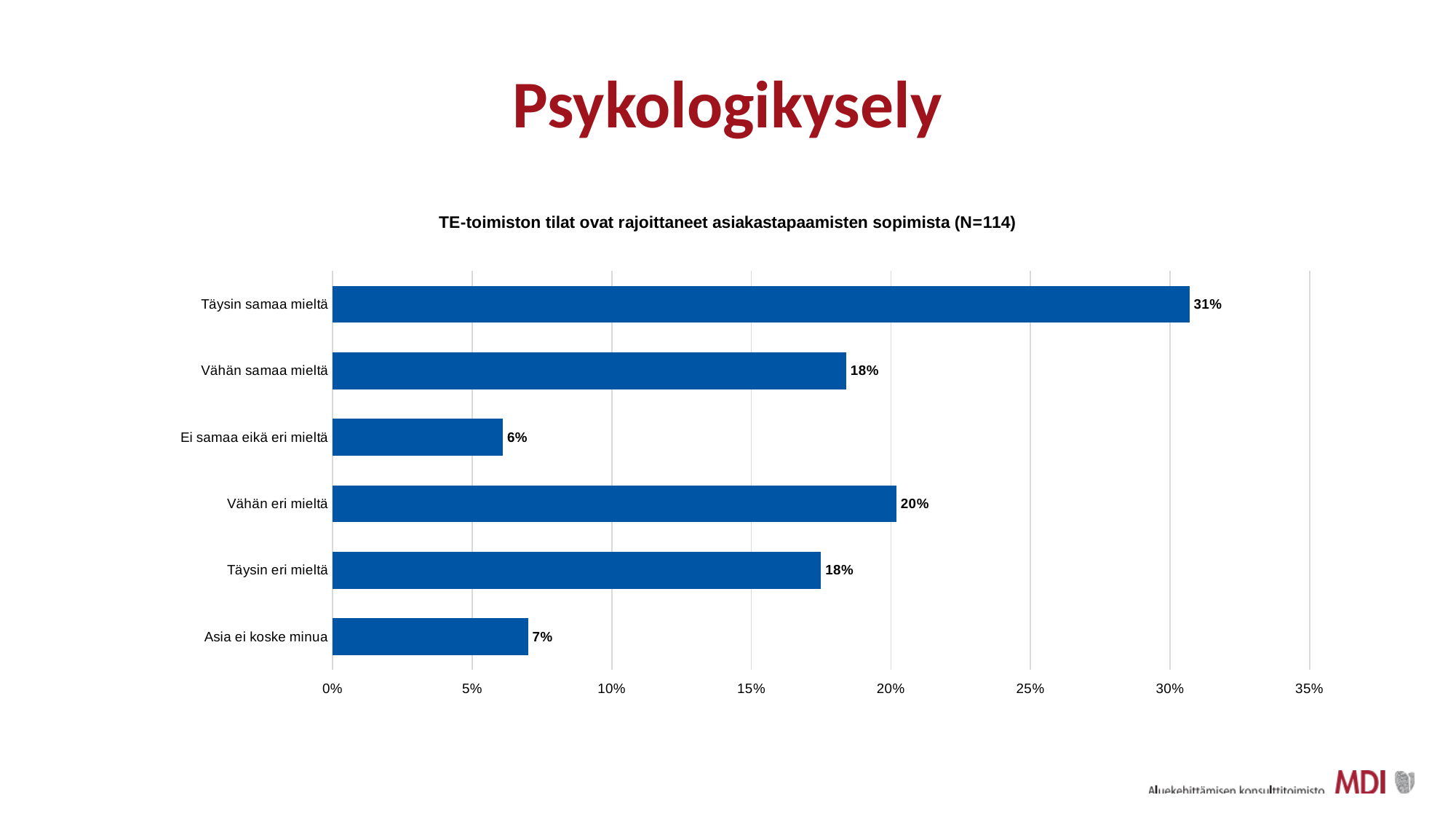
What is the value for "Ei samaa eikä eri mieltä"? 6% Which category has the lowest value? Ei samaa eikä eri mieltä What kind of chart is shown on the slide? bar chart How many categories are shown in the chart? 6 What is the value for "Asia ei koske minua"? 7% Which category has the highest value? Täysin samaa mieltä Which is larger, the value for "Vähän eri mieltä" or the value for "Vähän samaa mieltä"? Vähän eri mieltä What is the value for "Täysin samaa mieltä"? 31% What is the title of the chart? TE-toimiston tilat ovat rajoittaneet asiakastapaamisten sopimista (N=114) What is the difference between the values for "Täysin samaa mieltä" and "Vähän eri mieltä"? 11% What is the value for "Vähän eri mieltä"? 20% Is the value for "Täysin samaa mieltä" greater or less than 30%? greater